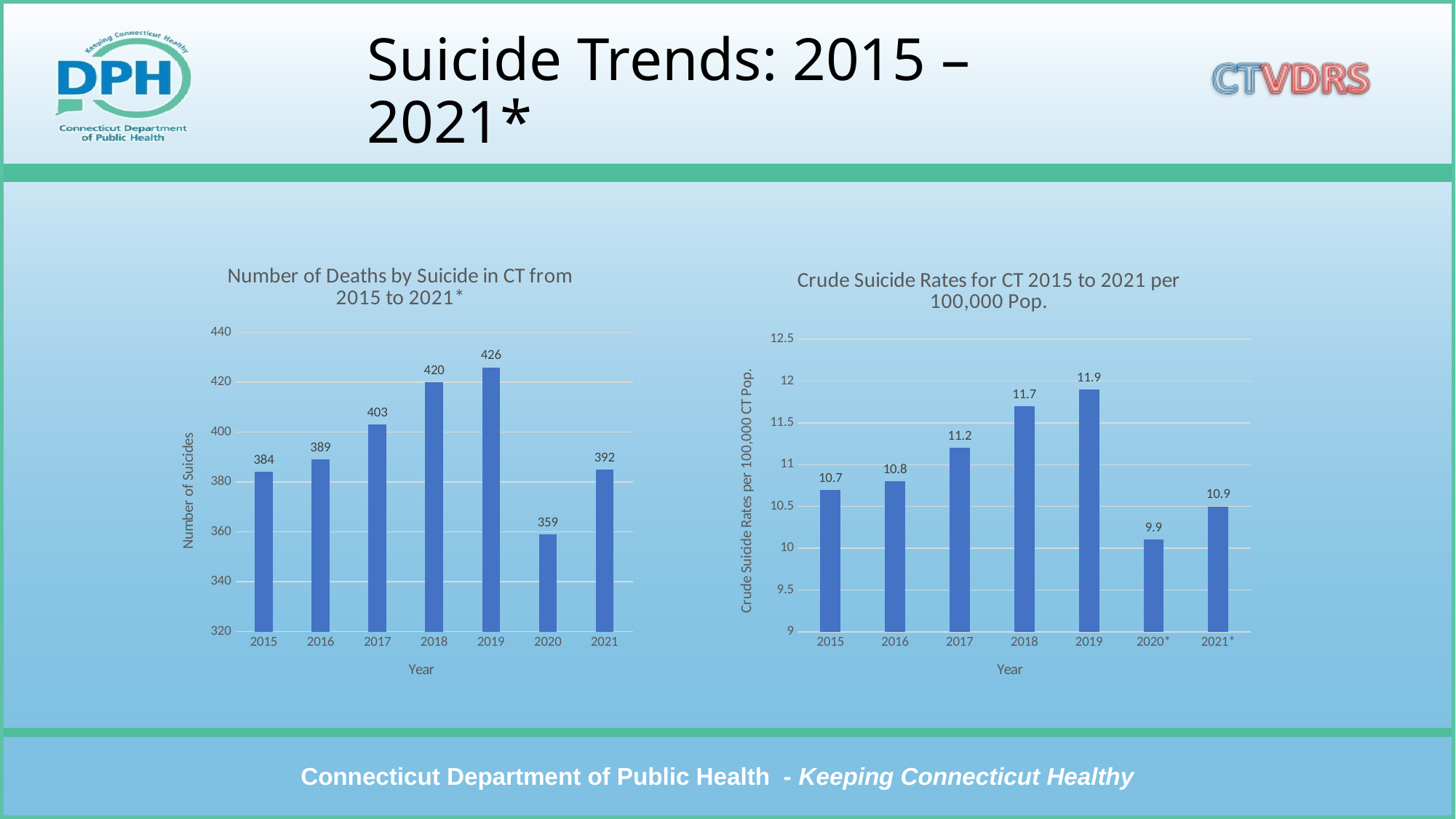
In the 'Crude Suicide Rates for CT 2015 to 2021 per 100,000 Pop.' chart, what is the value for 2017? 11.2 In the 'Crude Suicide Rates for CT 2015 to 2021 per 100,000 Pop.' chart, which year has the lowest crude suicide rate? 2020* In the 'Number of Deaths by Suicide in CT from 2015 to 2021*' chart, which year has the highest number of suicides? 2019 In the 'Crude Suicide Rates for CT 2015 to 2021 per 100,000 Pop.' chart, what is the difference between the values for 2019 and 2015? 1.2 In the 'Crude Suicide Rates for CT 2015 to 2021 per 100,000 Pop.' chart, do the values rise or fall from 2015 to 2019? Rise In the 'Number of Deaths by Suicide in CT from 2015 to 2021*' chart, how many years are shown on the x axis? 7 What kind of chart is the 'Number of Deaths by Suicide in CT from 2015 to 2021*' chart? Bar chart What is the y-axis label of the 'Crude Suicide Rates for CT 2015 to 2021 per 100,000 Pop.' chart? Crude Suicide Rates per 100,000 CT Pop. In the 'Number of Deaths by Suicide in CT from 2015 to 2021*' chart, what is the value for 2018? 420 In the 'Number of Deaths by Suicide in CT from 2015 to 2021*' chart, which year has the lowest number of suicides? 2020 In the 'Number of Deaths by Suicide in CT from 2015 to 2021*' chart, what is the difference between the values for 2019 and 2020? 67